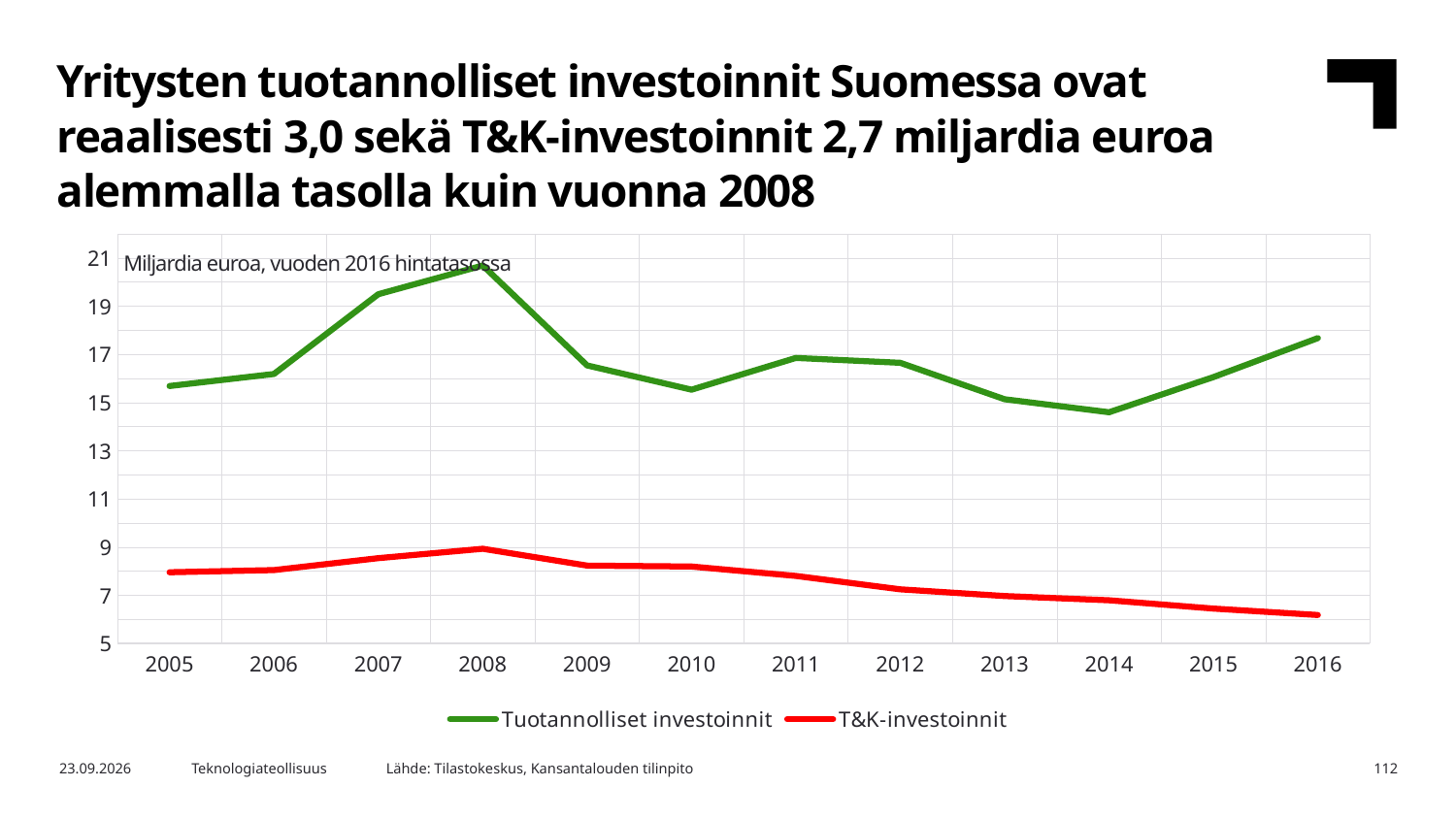
Is the value for Tuotannolliset investoinnit in 2008 greater or less than 19? greater Is the value for Tuotannolliset investoinnit in 2014 greater or less than 15? less In which year is the value for T&K-investoinnit highest? 2008 Do the values for T&K-investoinnit rise or fall from 2008 to 2016? fall What kind of chart is shown on the slide? line chart Is the value for T&K-investoinnit in 2016 greater or less than 7? less In which year is the value for T&K-investoinnit lowest? 2016 In which year is the value for Tuotannolliset investoinnit highest? 2008 In which year is the value for Tuotannolliset investoinnit lowest? 2014 Which is larger: the value for T&K-investoinnit in 2008 or in 2014? 2008 How many series does the legend list? 2 How many years are shown on the x axis? 12